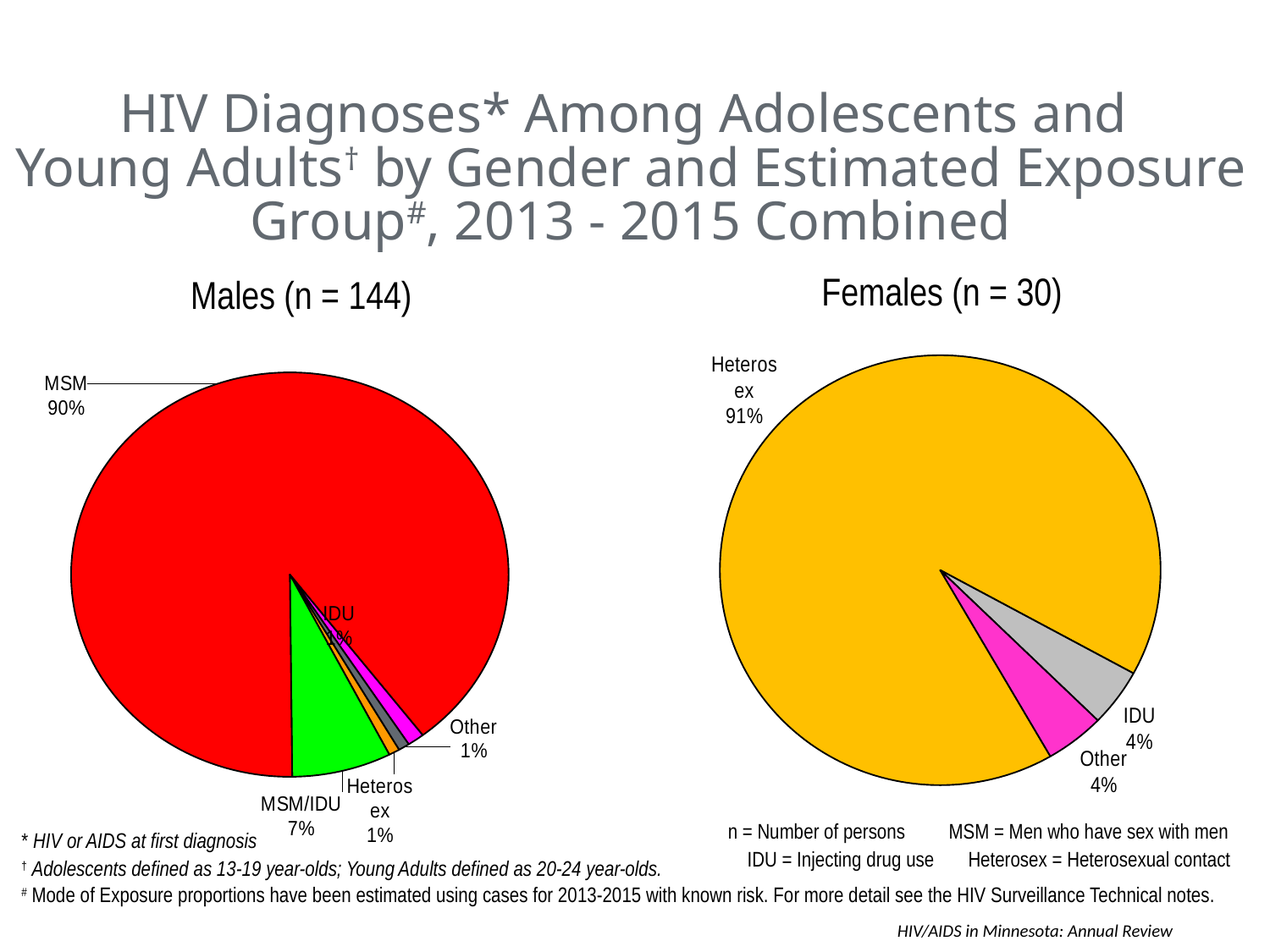
Which is larger: the MSM/IDU share in the Males pie chart or the IDU share in the Females pie chart? MSM/IDU share in the Males pie chart How many slices does the Females (n = 30) pie chart have? 3 In the Males (n = 144) pie chart, what share of diagnoses is attributed to Heterosex? 1% In the Females (n = 30) pie chart, what share of diagnoses is attributed to Other? 4% In the Females (n = 30) pie chart, which exposure group has the largest slice? Heterosex In the Males (n = 144) pie chart, what share of diagnoses is attributed to MSM/IDU? 7% In the Males (n = 144) pie chart, which exposure group has the largest slice? MSM In the Males (n = 144) pie chart, how many percentage points larger is the MSM share than the MSM/IDU share? 83 percentage points What kind of charts are shown on the slide? Pie charts